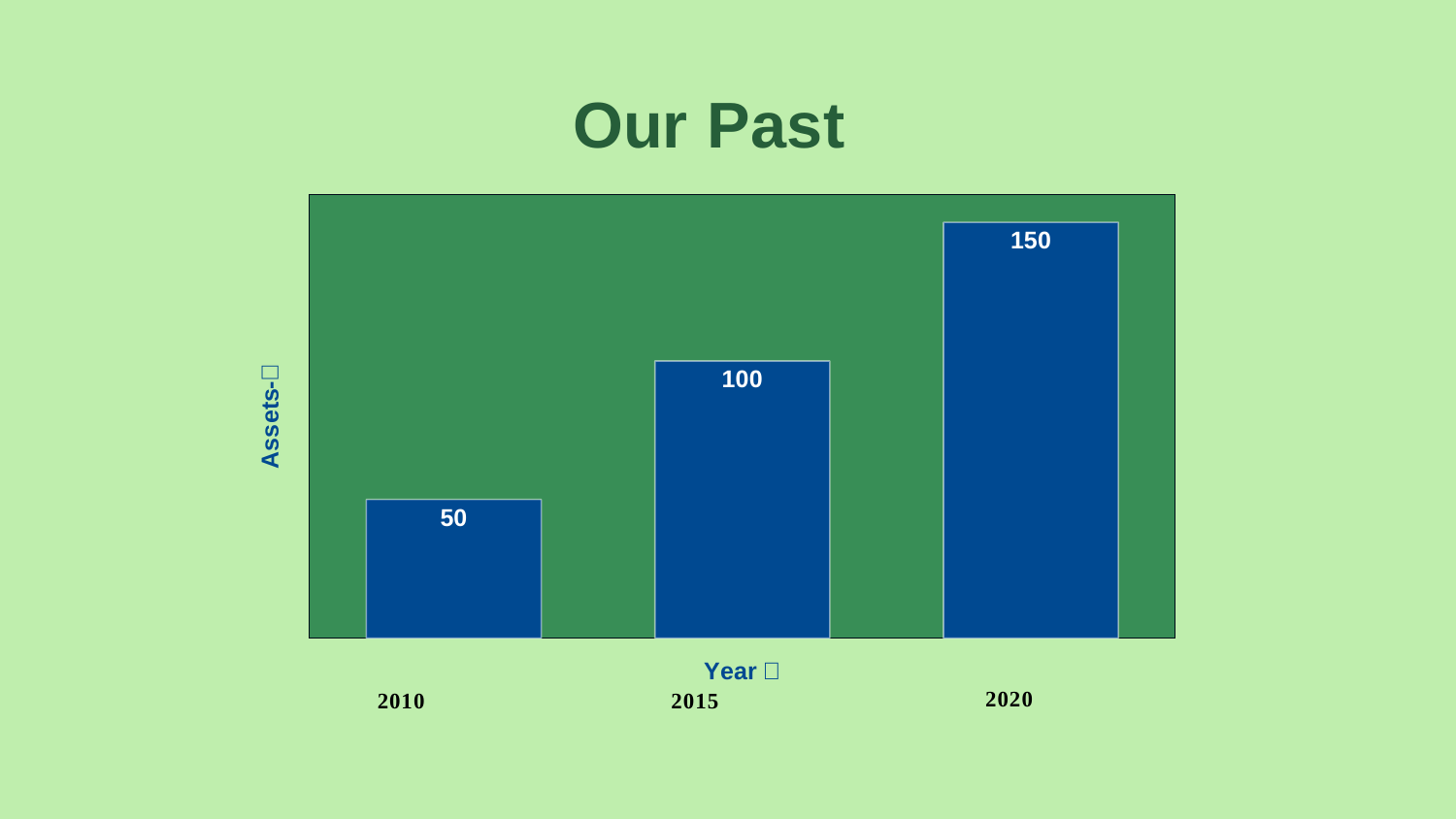
What is the difference between the values for 2020 and 2010? 100 How many years are shown on the chart? 3 Do the values rise or fall from 2010 to 2020? rise What is the value for 2015? 100 What is the difference between the values for 2015 and 2010? 50 What is the value for 2020? 150 What is the title of the slide containing the chart? Our Past Which year has the highest value? 2020 What kind of chart is shown on the slide? bar chart What is the value for 2010? 50 Which is larger, the value for 2015 or the value for 2020? 2020 Which year has the lowest value? 2010